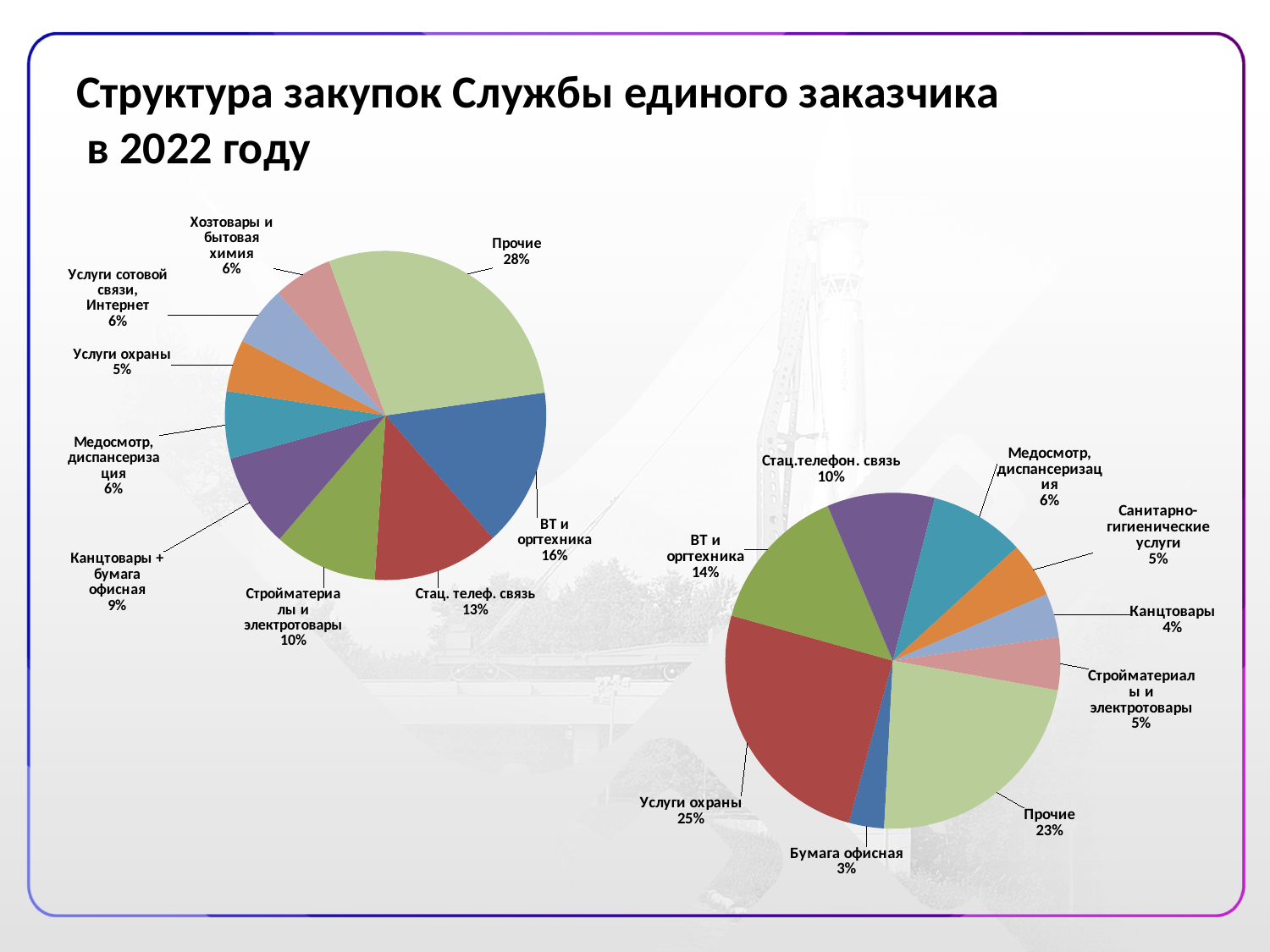
What type of chart is used on the slide? Pie chart In the right pie chart, which category has the largest share? Услуги охраны How many categories does the left pie chart show? 9 In the right pie chart, which is larger: "ВТ и оргтехника" or "Стац.телефон. связь"? ВТ и оргтехника In the left pie chart, what is the share of "ВТ и оргтехника"? 16% In the right pie chart, what share does "Услуги охраны" have? 25% In the left pie chart, what share does "Прочие" have? 28% In the left pie chart, which category has the largest share? Прочие In the left pie chart, what is the difference between the shares of "Прочие" and "Стац. телеф. связь"? 15% What is the title of the slide? Структура закупок Службы единого заказчика в 2022 году In the right pie chart, which category has the smallest share? Бумага офисная In the right pie chart, what is the share of "Бумага офисная"? 3%